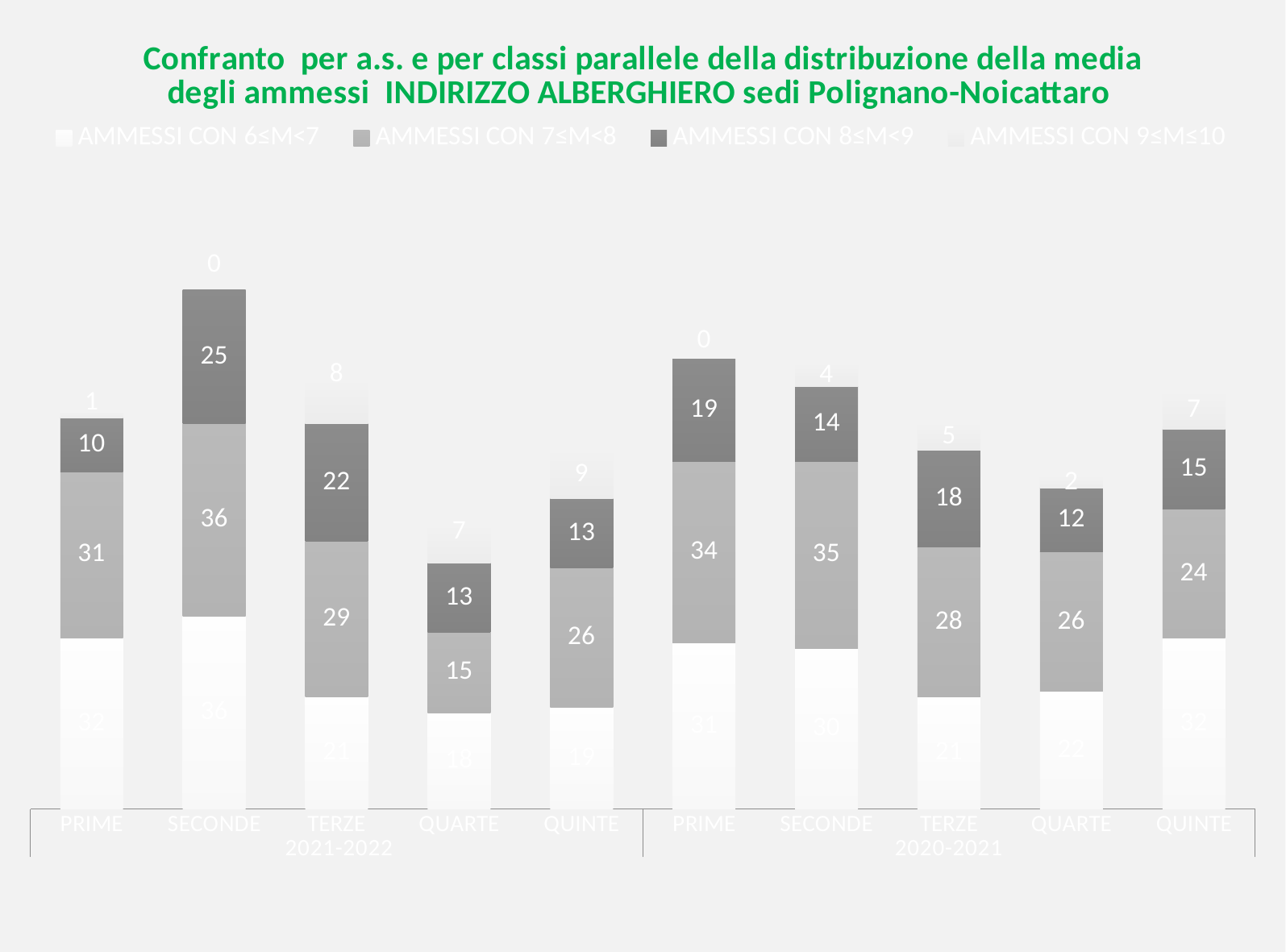
What is the difference between the AMMESSI CON 8≤M<9 values for TERZE in 2021-2022 and TERZE in 2020-2021? 4 What is the value for AMMESSI CON 8≤M<9 for SECONDE in 2021-2022? 25 What is the total of the stacked bar for TERZE in 2021-2022? 80 What kind of chart is shown on the slide? stacked bar chart What is the value for AMMESSI CON 7≤M<8 for PRIME in 2020-2021? 34 What is the value for AMMESSI CON 9≤M≤10 for QUINTE in 2021-2022? 9 How many series does the legend list? 4 How many bars (class groups) are plotted across both school years? 10 What is the value for AMMESSI CON 6≤M<7 for QUARTE in 2020-2021? 22 Which is larger: the AMMESSI CON 7≤M<8 value for QUINTE in 2021-2022 or for QUINTE in 2020-2021? QUINTE 2021-2022 Which bar is the tallest overall? SECONDE 2021-2022 Which bar is the shortest overall? QUARTE 2021-2022